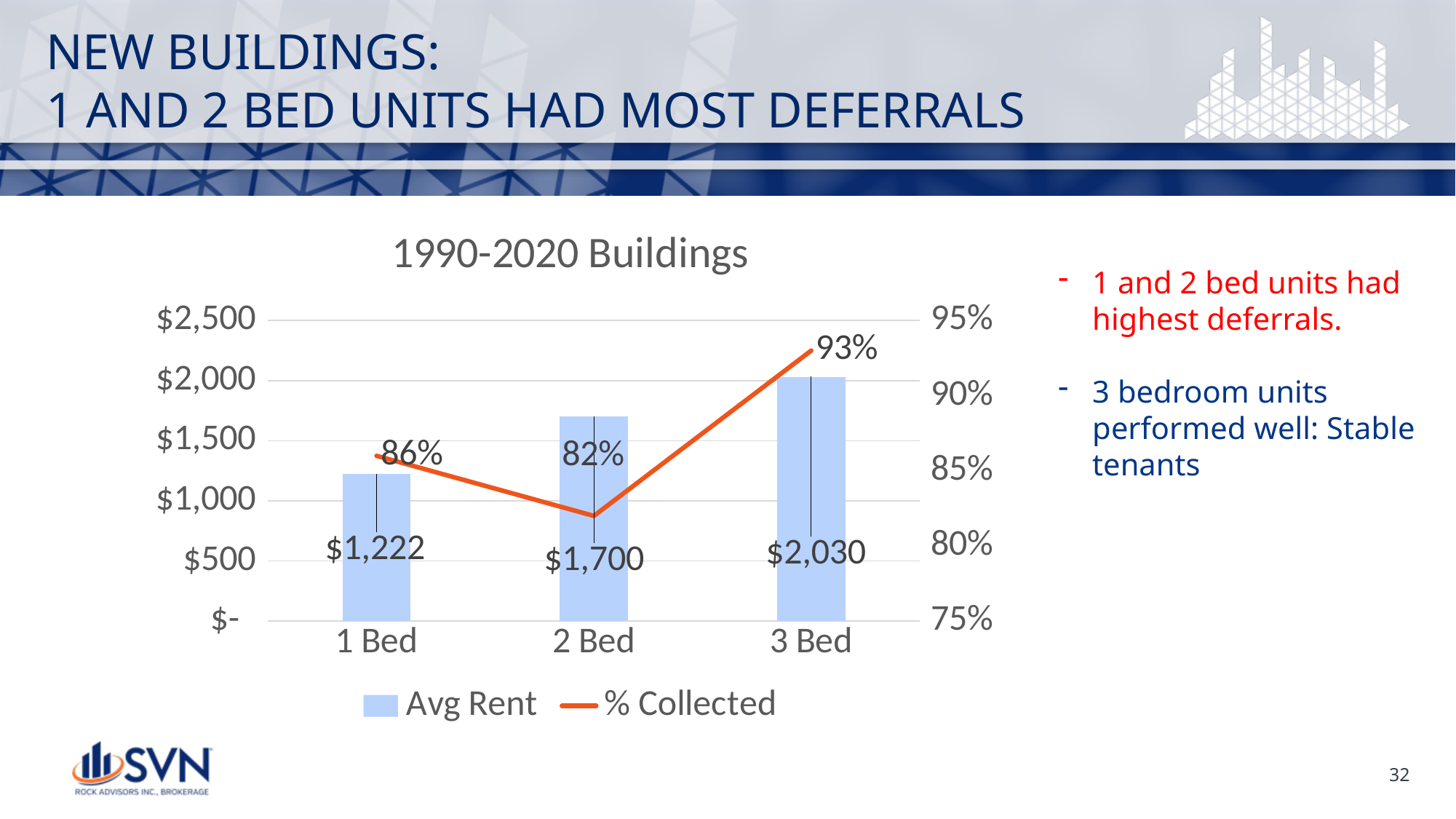
What is the title of the chart? 1990-2020 Buildings How many unit types are shown on the x axis? 3 What percentage of rent was collected for 3 Bed units? 93% What is the difference in % Collected between 3 Bed and 1 Bed units? 7% What is the average rent for 3 Bed units? $2,030 Which unit type has the highest average rent? 3 Bed What is the average rent for 1 Bed units? $1,222 What is the difference in average rent between 3 Bed and 2 Bed units? $330 Which has a higher % Collected, 1 Bed or 2 Bed? 1 Bed What percentage of rent was collected for 2 Bed units? 82% How many series does the legend list? 2 Which unit type has the lowest % Collected? 2 Bed